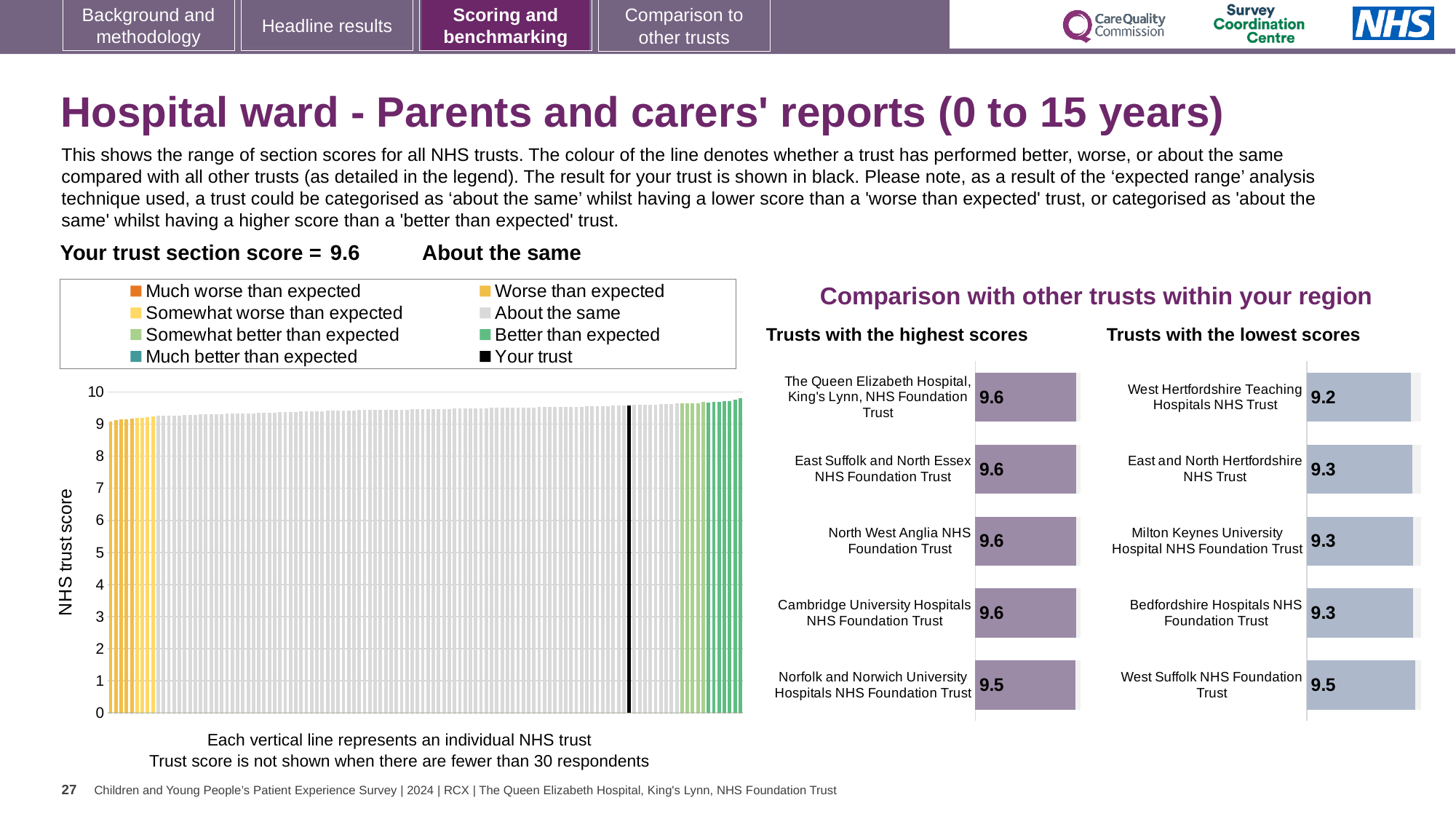
In the 'Trusts with the highest scores' chart, what is the difference between the scores of Cambridge University Hospitals NHS Foundation Trust and Norfolk and Norwich University Hospitals NHS Foundation Trust? 0.1 In the 'Trusts with the lowest scores' chart, which trust has the lowest score? West Hertfordshire Teaching Hospitals NHS Trust In the 'Trusts with the lowest scores' chart, which trust has the highest score? West Suffolk NHS Foundation Trust In the 'Trusts with the highest scores' chart, which trust has the lowest score? Norfolk and Norwich University Hospitals NHS Foundation Trust In the 'Trusts with the lowest scores' chart, what is the score for West Suffolk NHS Foundation Trust? 9.5 In the 'Trusts with the lowest scores' chart, which has the larger score: Bedfordshire Hospitals NHS Foundation Trust or West Hertfordshire Teaching Hospitals NHS Trust? Bedfordshire Hospitals NHS Foundation Trust In the 'Trusts with the highest scores' chart, what is the score for Norfolk and Norwich University Hospitals NHS Foundation Trust? 9.5 In the main chart on the left showing the range of section scores, is the value for 'Your trust' greater or less than 9? greater How many trusts are listed in the 'Trusts with the highest scores' chart? 5 In the 'Trusts with the lowest scores' chart, what is the difference between the scores of West Suffolk NHS Foundation Trust and West Hertfordshire Teaching Hospitals NHS Trust? 0.3 In the 'Trusts with the lowest scores' chart, what is the score for West Hertfordshire Teaching Hospitals NHS Trust? 9.2 How many entries does the legend of the main chart on the left list? 8